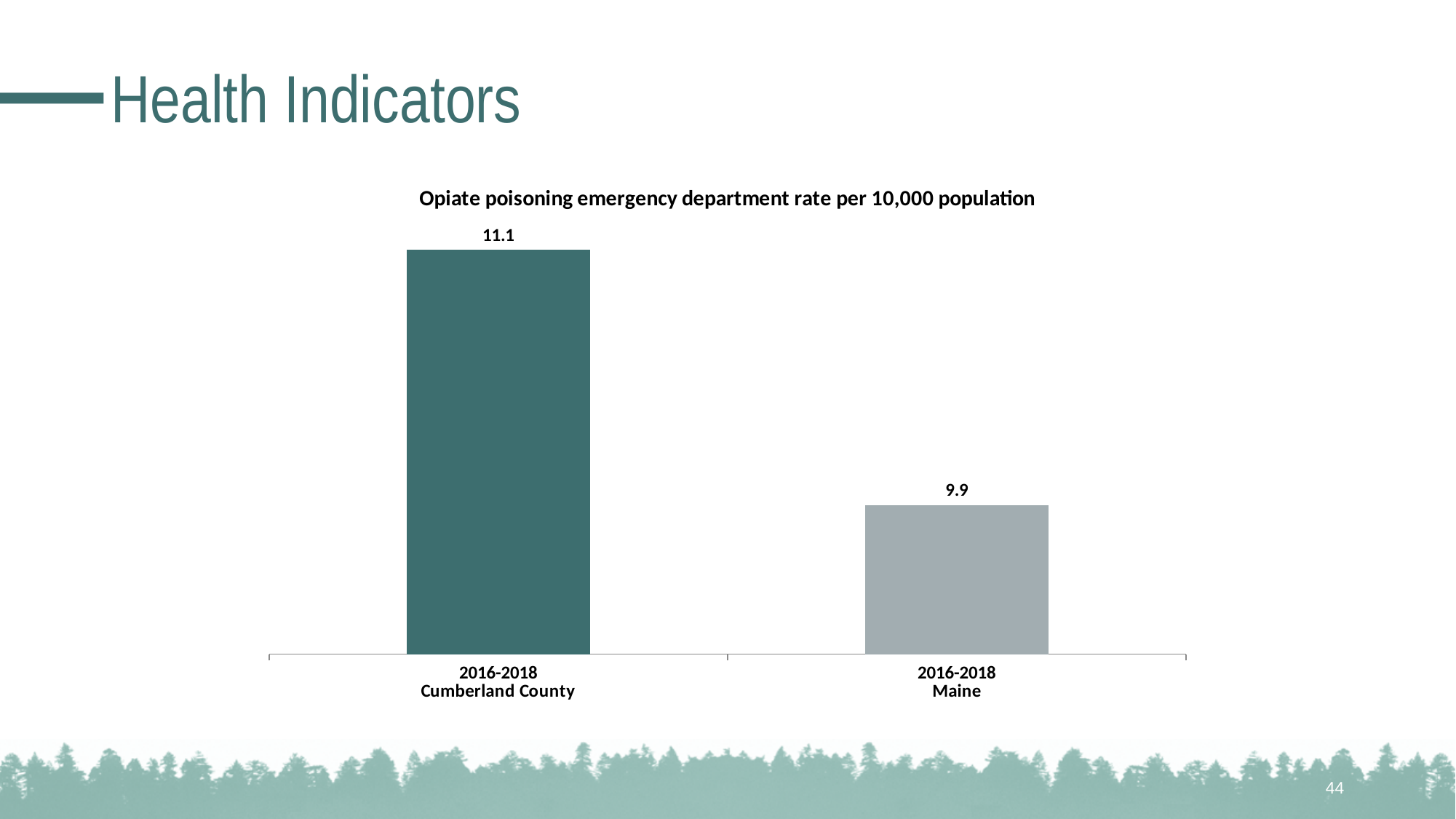
Which category has the lower opiate poisoning emergency department rate? Maine What is the difference between the Cumberland County rate and the Maine rate? 1.2 What is the opiate poisoning emergency department rate per 10,000 population for Maine in 2016-2018? 9.9 What time period do both bars in the chart cover? 2016-2018 Is the rate for Cumberland County larger or smaller than the rate for Maine? larger How many bars are shown in the chart? 2 What kind of chart is shown on the slide? bar chart What is the opiate poisoning emergency department rate per 10,000 population for Cumberland County in 2016-2018? 11.1 What is the title of the chart? Opiate poisoning emergency department rate per 10,000 population Which category has the higher opiate poisoning emergency department rate, Cumberland County or Maine? Cumberland County